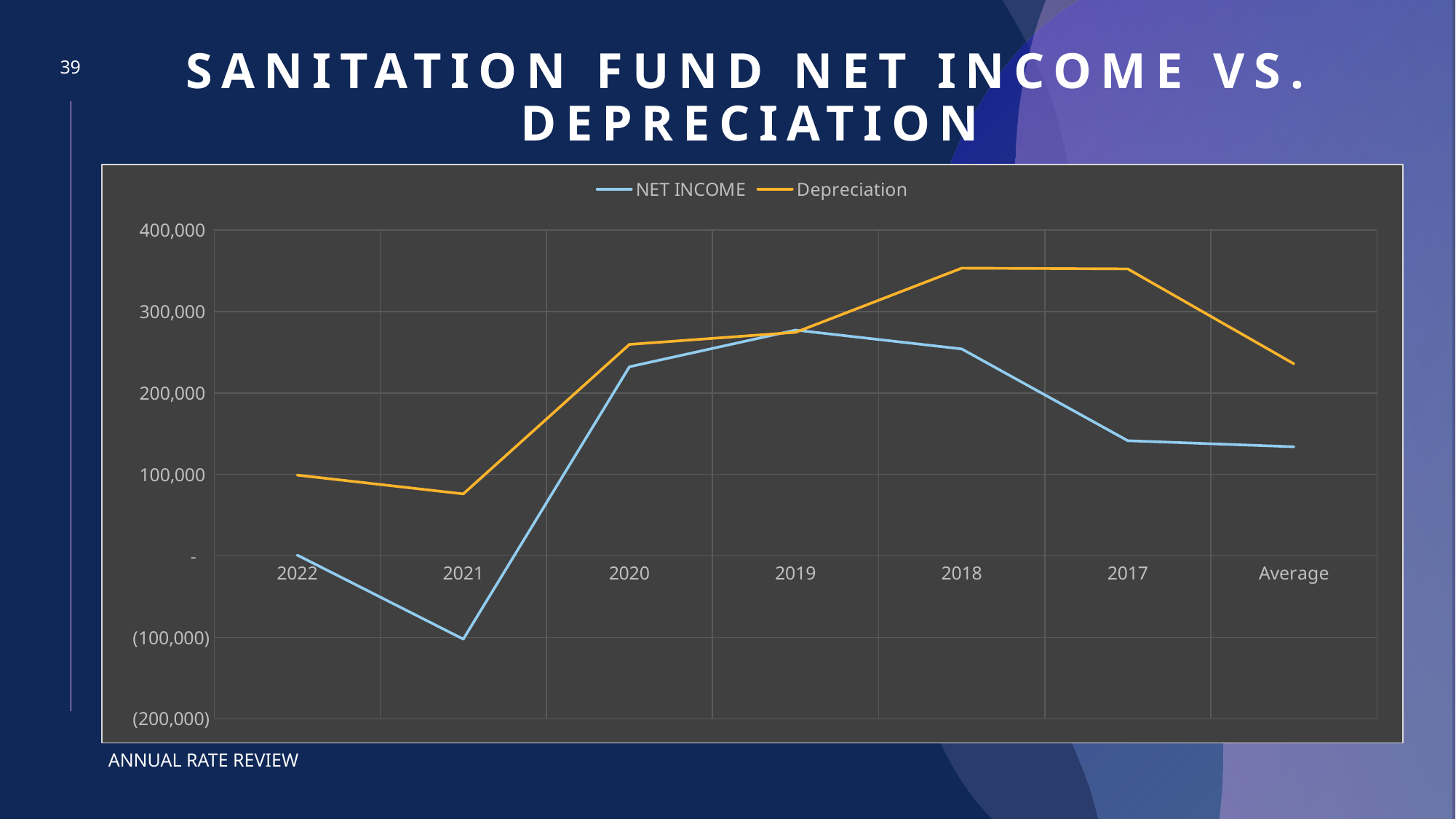
What colour is the Depreciation line? orange For 2017, which is larger: NET INCOME or Depreciation? Depreciation What kind of chart is shown on the slide? line chart Is the NET INCOME value for 2021 greater or less than 100,000? less In which category is NET INCOME highest? 2019 In which category is NET INCOME lowest? 2021 In which category is Depreciation lowest? 2021 Is the NET INCOME value for Average greater or less than 200,000? less How many series does the legend list? 2 Is the Depreciation value for 2018 greater or less than 300,000? greater Does NET INCOME rise or fall from 2019 to 2017 along the x axis? fall How many categories are shown along the x axis? 7